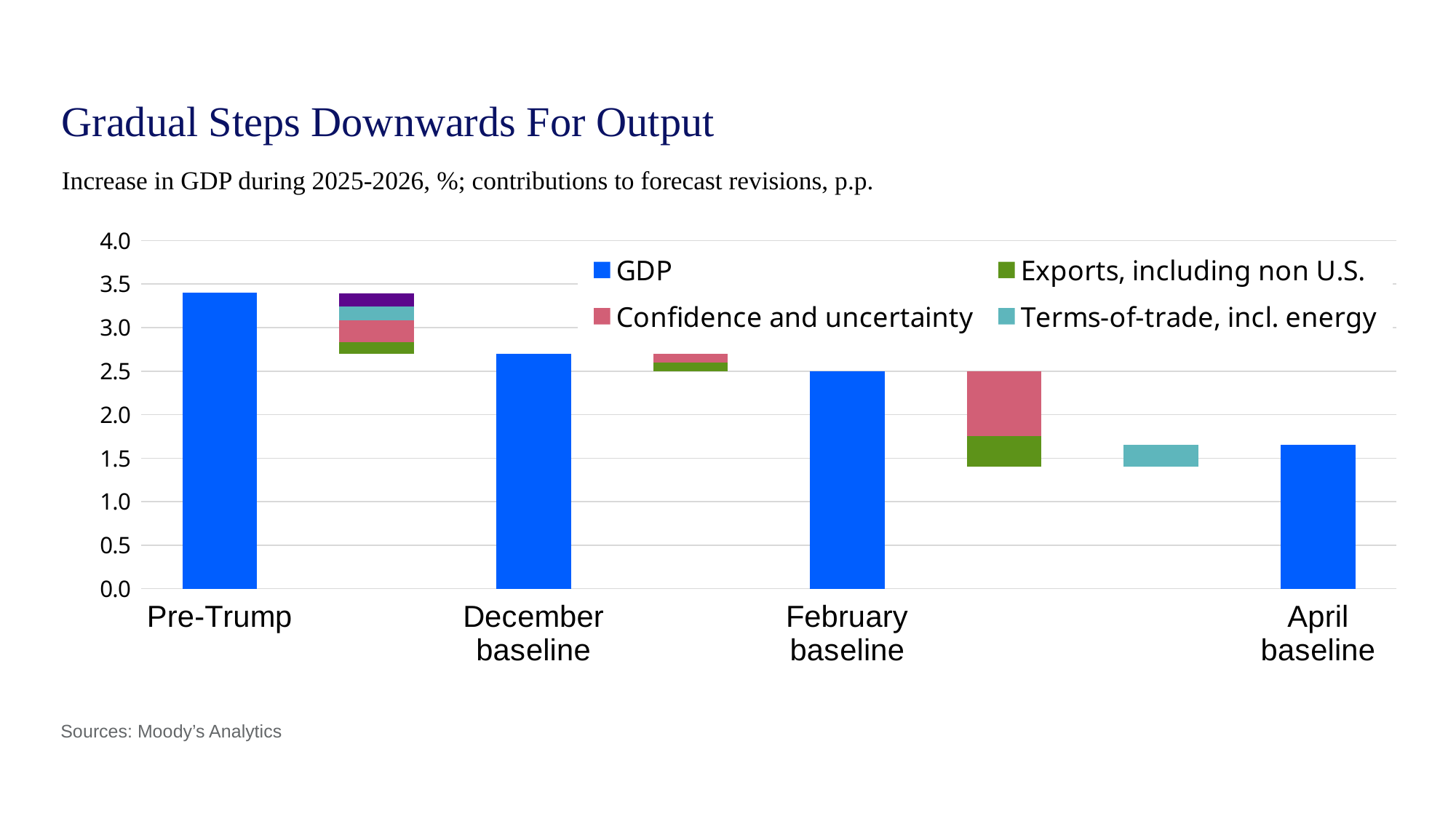
Which category has the lowest GDP bar? April baseline Is the GDP value for Pre-Trump greater or less than 3.0? greater What source is cited for the chart? Moody's Analytics Is the GDP value for December baseline greater or less than 2.5? greater Which is larger, the GDP bar for December baseline or the GDP bar for February baseline? December baseline What kind of chart is shown on the slide? Bar chart How many labeled categories are shown on the x axis? 4 Which category has the highest GDP bar? Pre-Trump How many series does the legend list? 4 What is the title of the chart on the slide? Gradual Steps Downwards For Output Is the GDP value for April baseline greater or less than 2.0? less Do the GDP bars rise or fall from Pre-Trump to April baseline? Fall